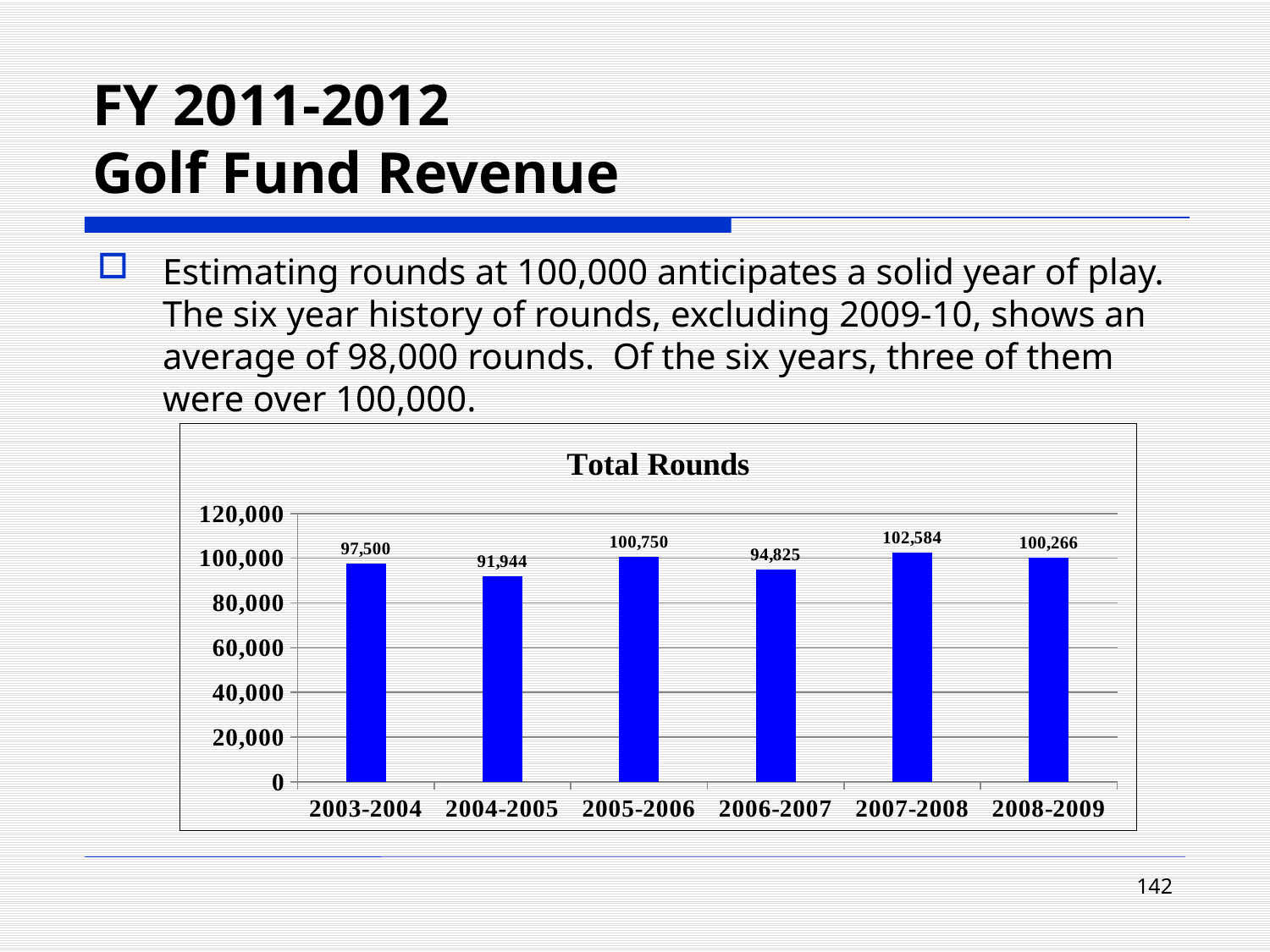
What is the value for 2007-2008 in the Total Rounds chart? 102,584 What is the value for 2004-2005 in the Total Rounds chart? 91,944 What is the value for 2003-2004 in the Total Rounds chart? 97,500 Which is larger, the total rounds for 2005-2006 or for 2008-2009? 2005-2006 What is the title of the chart? Total Rounds What is the difference between the total rounds in 2007-2008 and 2004-2005? 10,640 Which year has the lowest total rounds? 2004-2005 How many years are shown on the x axis of the Total Rounds chart? 6 Which year has the highest total rounds? 2007-2008 What is the difference between the total rounds in 2003-2004 and 2006-2007? 2,675 Is the value for 2006-2007 greater or less than 100,000? less What kind of chart is used to show Total Rounds? bar chart